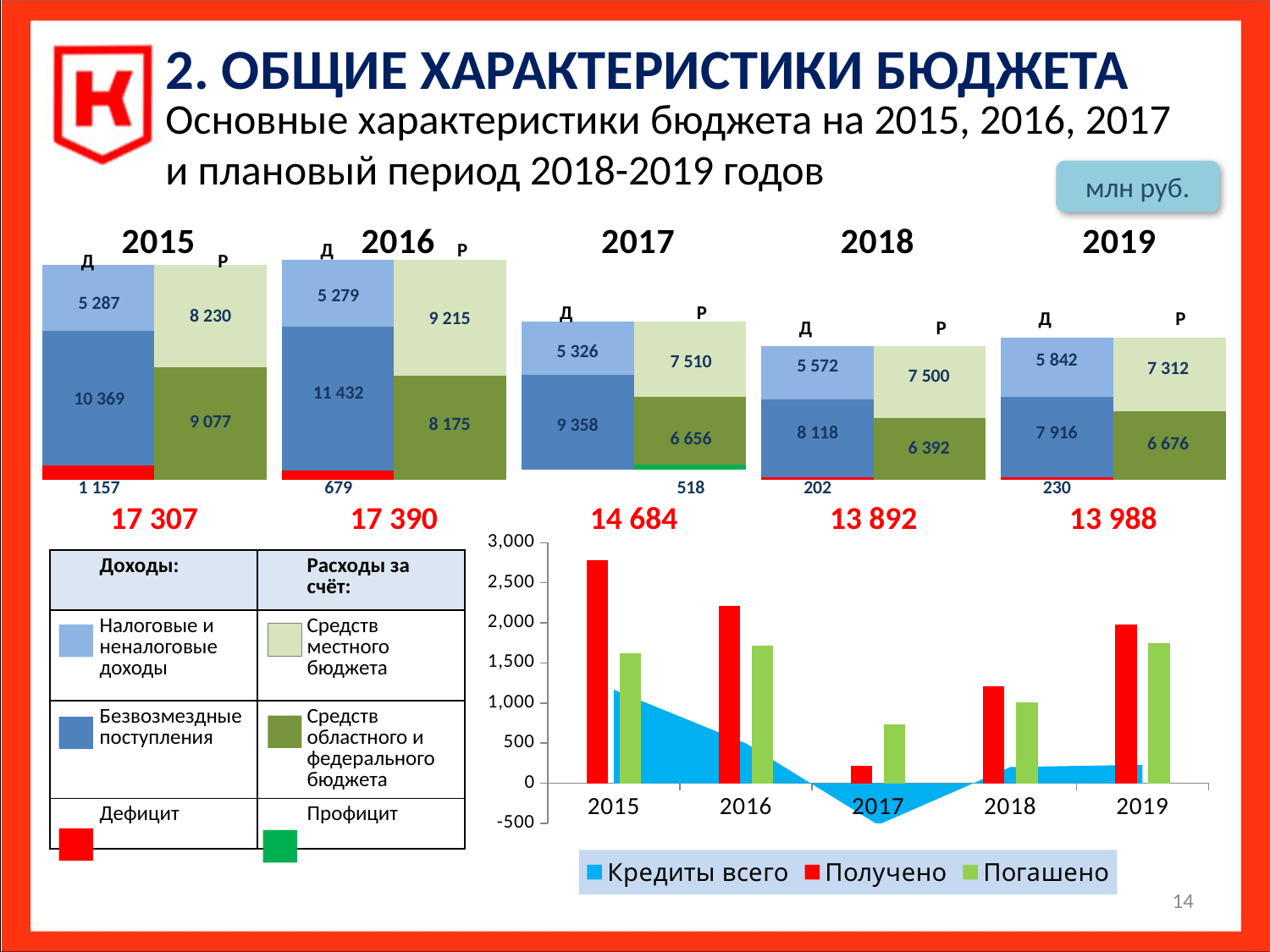
In the top chart, what is the difference between средств местного бюджета in 2016 and in 2015? 985 In the bottom chart, how many years are shown on the x axis? 5 In the top chart, which year has the lowest value of средств местного бюджета? 2019 In the bottom chart, is the value of Получено for 2015 greater or less than 2,500? greater In the top chart, what is the value of налоговые и неналоговые доходы for 2015? 5 287 In the bottom chart, is the value of Получено for 2017 greater or less than 500? less In the top chart, what is the value of средств областного и федерального бюджета for 2019? 6 676 In the top chart, what is the value of безвозмездные поступления for 2016? 11 432 In the top chart, which year has the highest value of безвозмездные поступления? 2016 In the bottom chart, how many series does the legend list? 3 In the top chart, which is larger for 2018: налоговые и неналоговые доходы or средств областного и федерального бюджета? средств областного и федерального бюджета In the top chart, what total is shown in red under the 2017 bars? 14 684